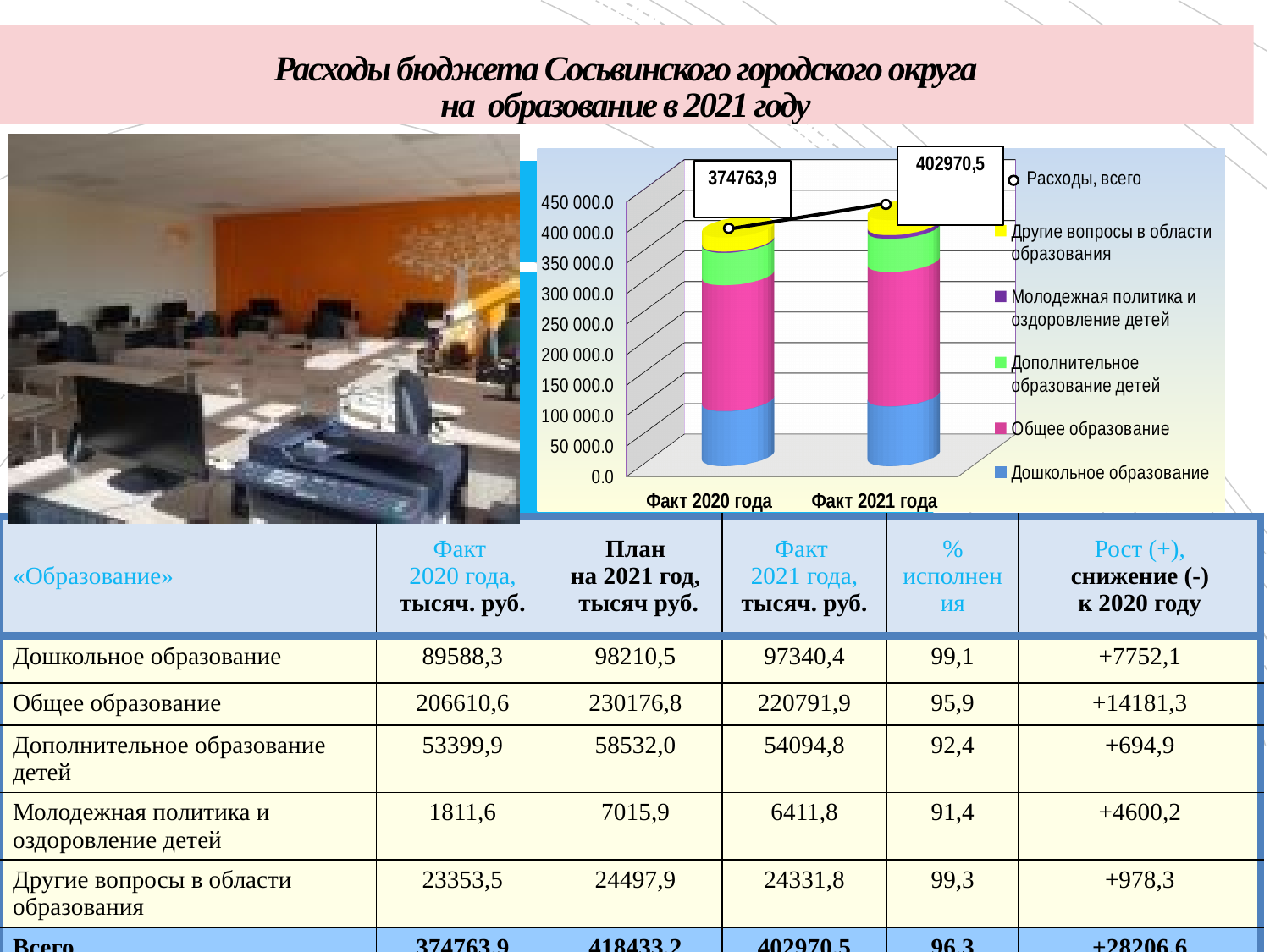
Which category has the higher 'Расходы, всего' value, 'Факт 2020 года' or 'Факт 2021 года'? Факт 2021 года How many categories are shown on the x axis of the chart? 2 What is the value of the 'Расходы, всего' line for 'Факт 2021 года'? 402970,5 Which legend entry is represented by the line with circle markers? Расходы, всего Is the 'Дошкольное образование' segment for 'Факт 2021 года' greater or less than 150 000.0? less Which legend entry is shown in pink in the chart? Общее образование Does the 'Расходы, всего' line rise or fall from 'Факт 2020 года' to 'Факт 2021 года'? rise What is the value of the 'Расходы, всего' line for 'Факт 2020 года'? 374763,9 What is the difference between the 'Расходы, всего' values for 'Факт 2021 года' and 'Факт 2020 года'? 28206,6 What type of chart is shown on the slide? bar chart Is the 'Расходы, всего' value for 'Факт 2020 года' greater or less than 350 000.0? greater How many entries does the chart legend list? 6